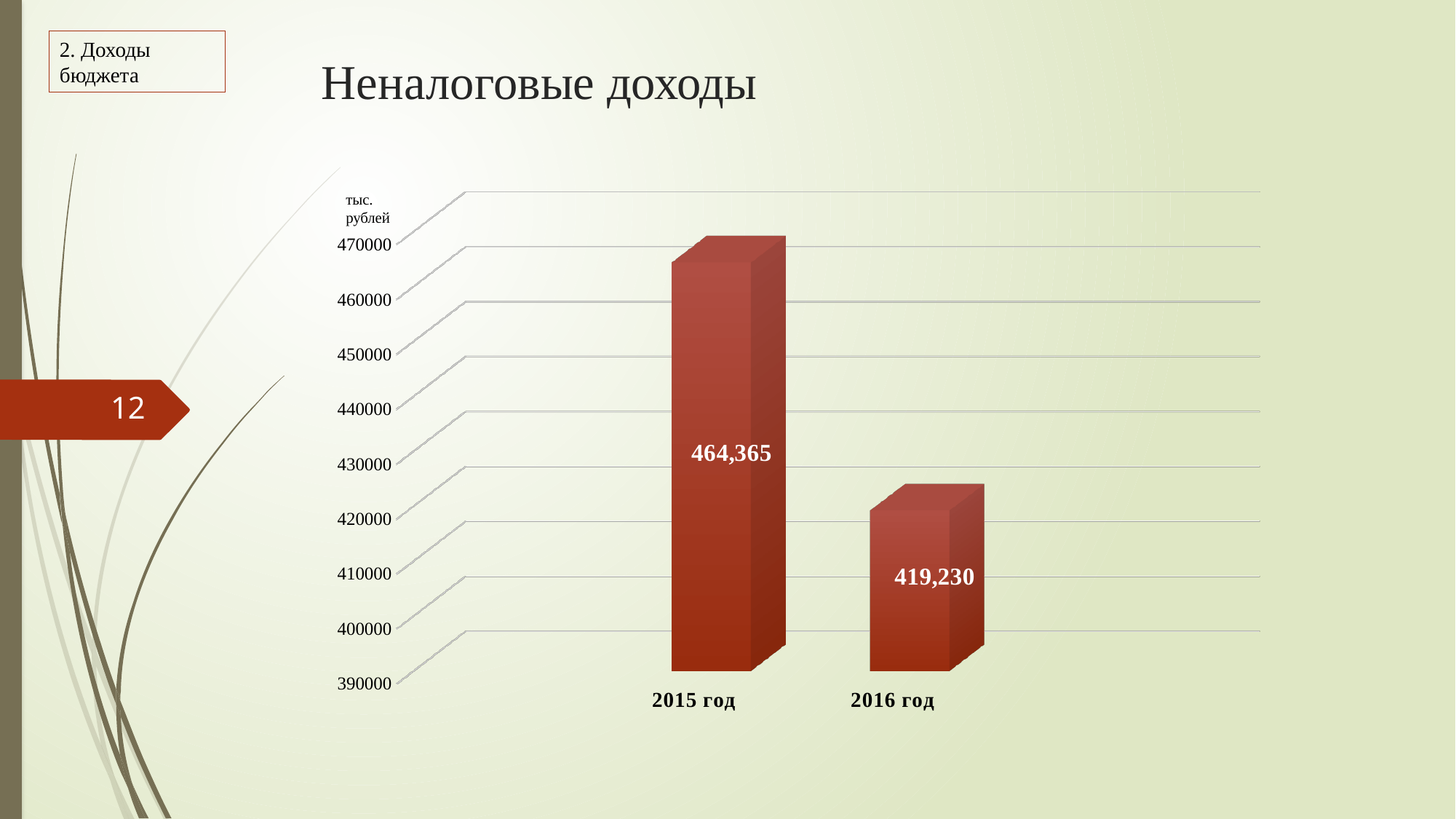
Is the value for 2015 год greater or less than 460000? greater Which is larger, the value for 2015 год or the value for 2016 год? 2015 год Which year has the highest value? 2015 год What is the difference between the values for 2015 год and 2016 год? 45,135 Which year has the lowest value? 2016 год What kind of chart is shown on the slide? bar chart What is the title of the chart? Неналоговые доходы How many categories are shown on the x axis? 2 What is the value for 2016 год? 419,230 Is the value for 2016 год greater or less than 430000? less Do the values rise or fall from 2015 год to 2016 год? fall What is the value for 2015 год? 464,365